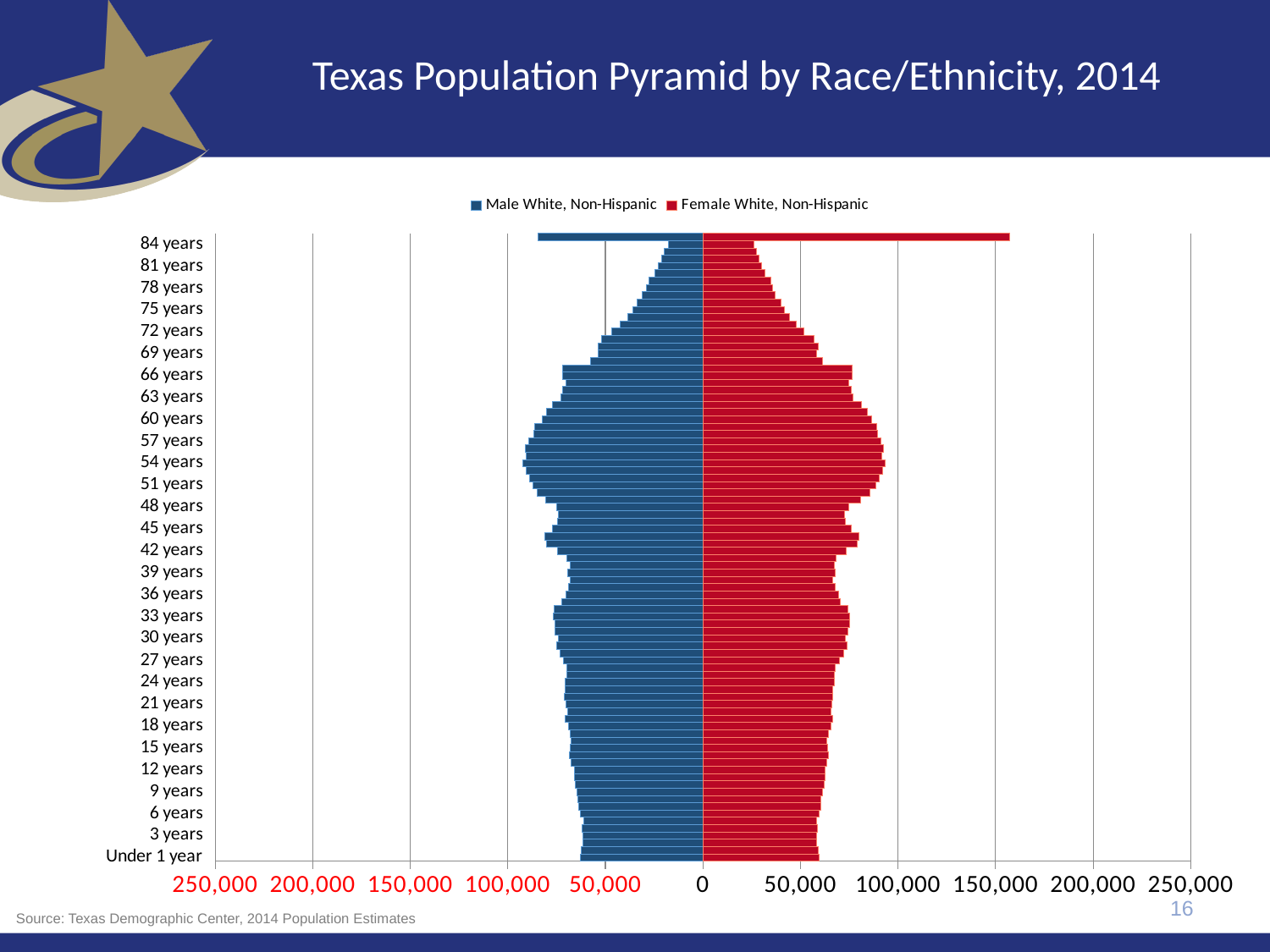
Is the Female White, Non-Hispanic value for 54 years greater or less than 50,000? greater Is the Male White, Non-Hispanic value for Under 1 year greater or less than 100,000? less Do the Female White, Non-Hispanic bars get longer or shorter going from 54 years up to 81 years? Shorter For the topmost bar, which is larger: the Male White, Non-Hispanic value or the Female White, Non-Hispanic value? Female White, Non-Hispanic Is the Female White, Non-Hispanic value for the topmost bar greater or less than 100,000? greater How many age labels are shown on the vertical axis? 29 How many series does the legend list? 2 What is the title of the slide's chart? Texas Population Pyramid by Race/Ethnicity, 2014 What kind of chart is shown on the slide? Bar chart Which series is shown in red? Female White, Non-Hispanic Which is larger: the Female White, Non-Hispanic value for 54 years or for the topmost bar? The topmost bar